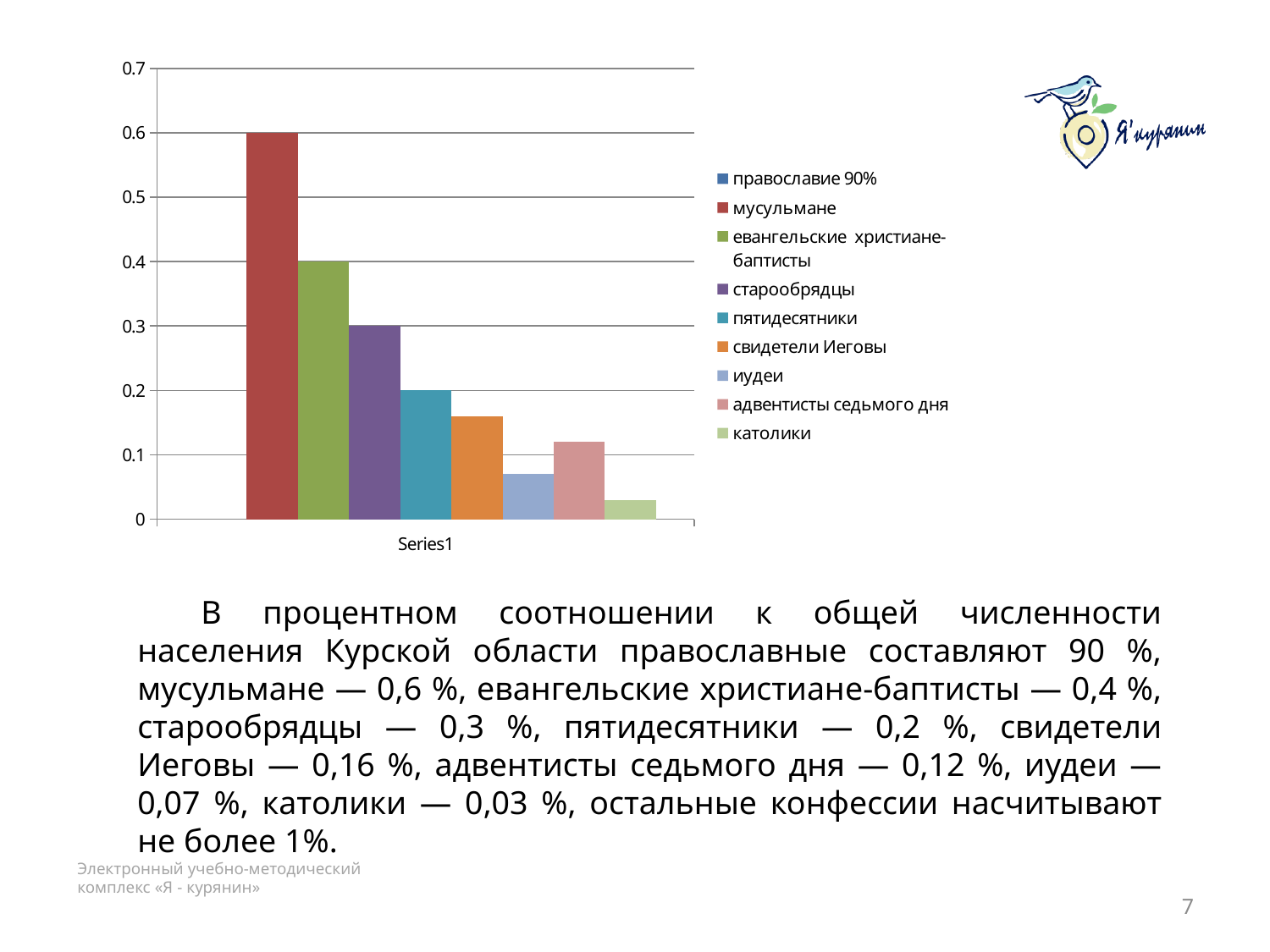
What is the value of the bar for евангельские христиане-баптисты? 0.4 Do the bar heights rise or fall from left to right across the chart? fall What is the difference between the bars for мусульмане and старообрядцы? 0.3 Is the value for иудеи greater or less than 0.1? less How many entries does the chart legend list? 9 Which category has the shortest bar in the chart? католики What is the value of the bar for мусульмане? 0.6 Which category has the tallest bar in the chart? мусульмане Which bar is taller: свидетели Иеговы or адвентисты седьмого дня? свидетели Иеговы What is the value of the bar for пятидесятники? 0.2 What kind of chart is shown on the slide? bar chart What is the value of the bar for старообрядцы? 0.3